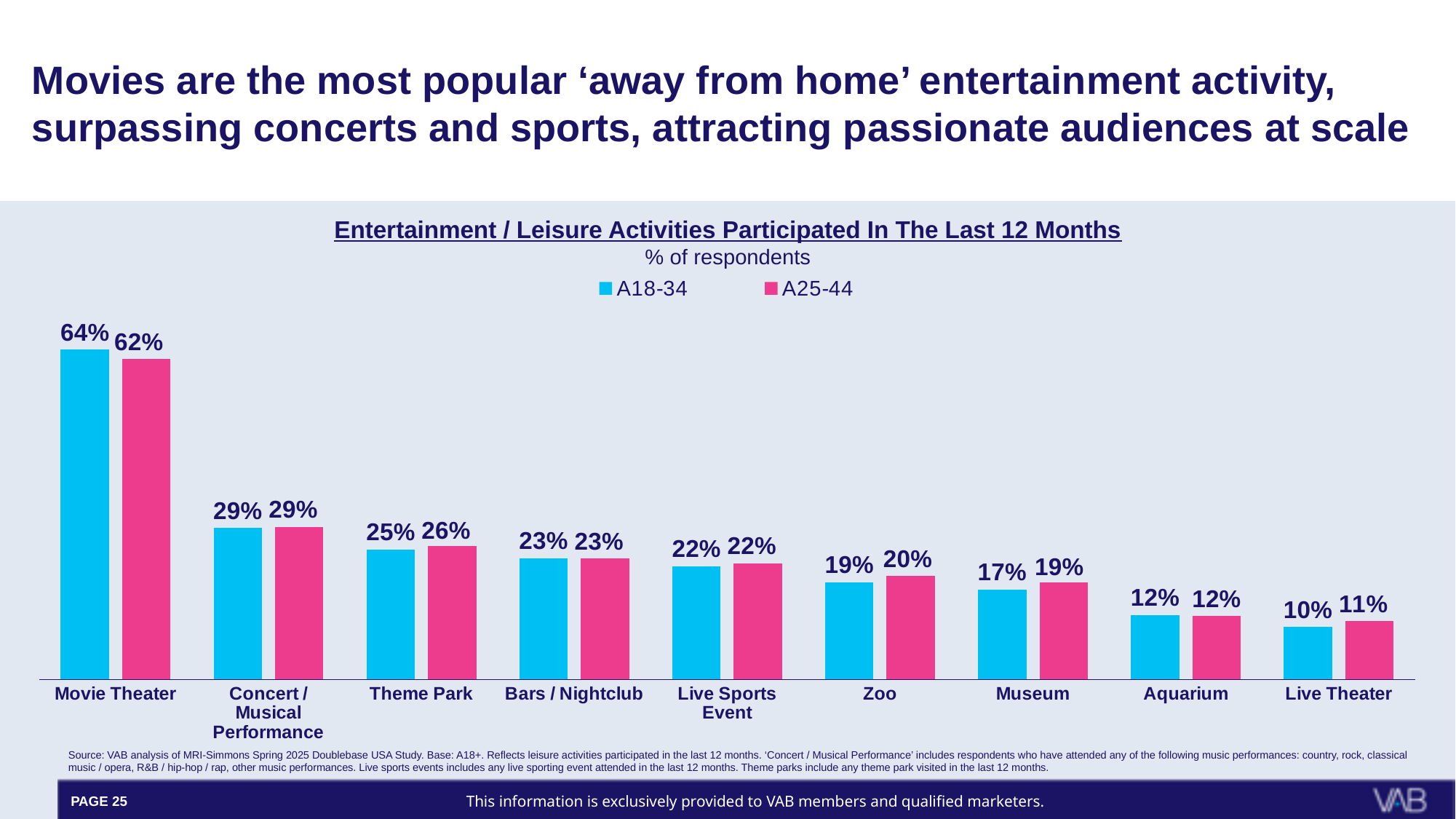
What is the difference between the A18-34 and A25-44 values for Movie Theater? 2% Which colour represents the A25-44 series? Pink What is the value for A18-34 for Movie Theater? 64% How many series does the legend list? 2 What is the difference between the A18-34 values for Movie Theater and Concert / Musical Performance? 35% Which category has the lowest value for A18-34? Live Theater How many categories are shown on the x axis? 9 What kind of chart is shown on the slide? Bar chart What is the value for A18-34 for Zoo? 19% Which is larger for Theme Park: the A18-34 value or the A25-44 value? A25-44 What is the value for A25-44 for Museum? 19% Which category has the highest value for A25-44? Movie Theater